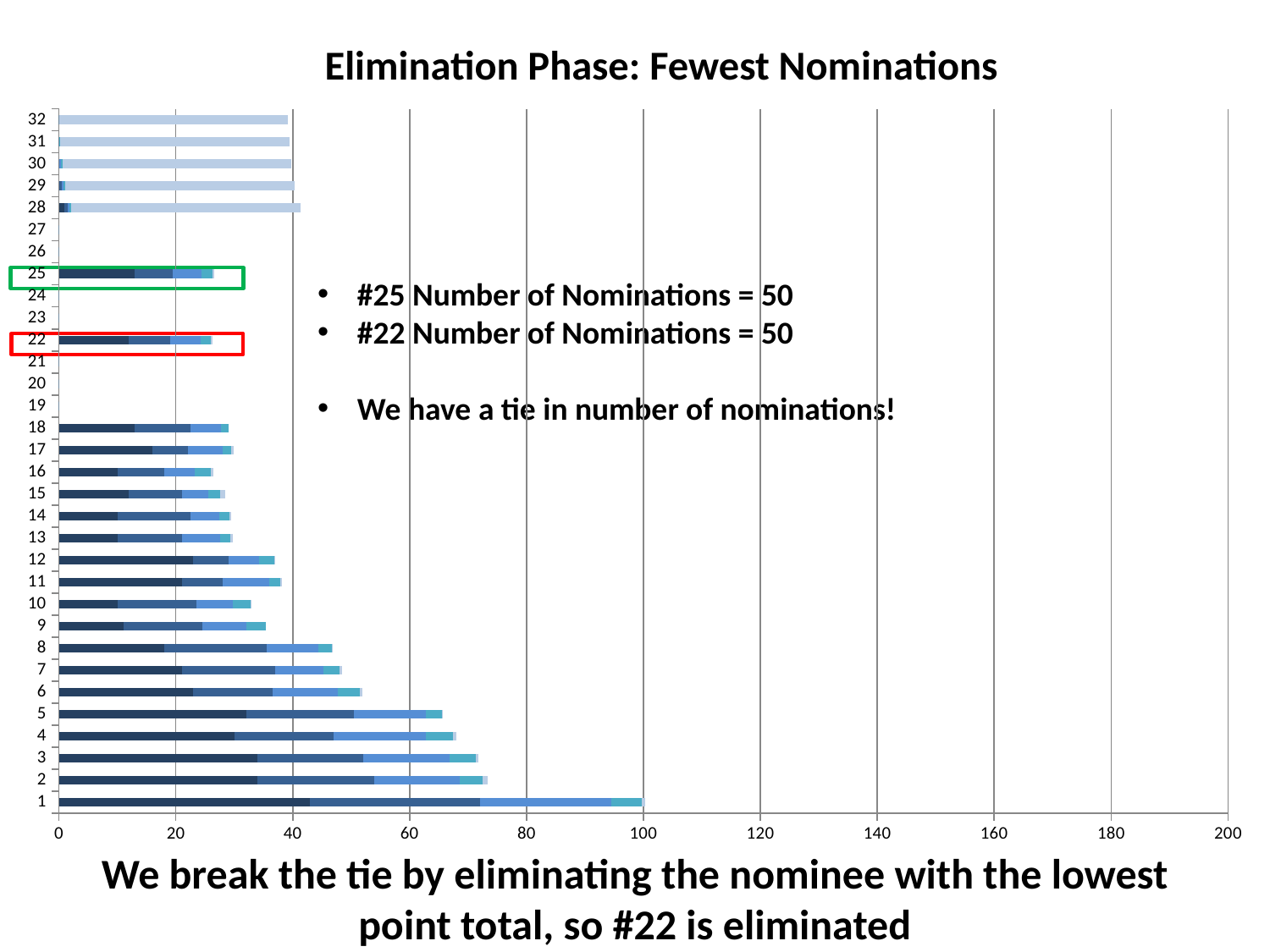
What is the title of the chart? Elimination Phase: Fewest Nominations What is the highest value shown on the horizontal axis? 200 Is the total bar length for category 1 greater or less than 80? greater Is the total bar length for category 18 greater or less than 40? less Is the total bar length for category 8 greater or less than 40? greater Which category's bar is outlined with a green box? 25 How many categories are listed on the vertical axis of the chart? 32 What kind of chart is shown on the slide? bar chart Which category has the longest bar in the chart? 1 Which has the longer bar, category 5 or category 6? 5 Which has the longer bar, category 1 or category 2? 1